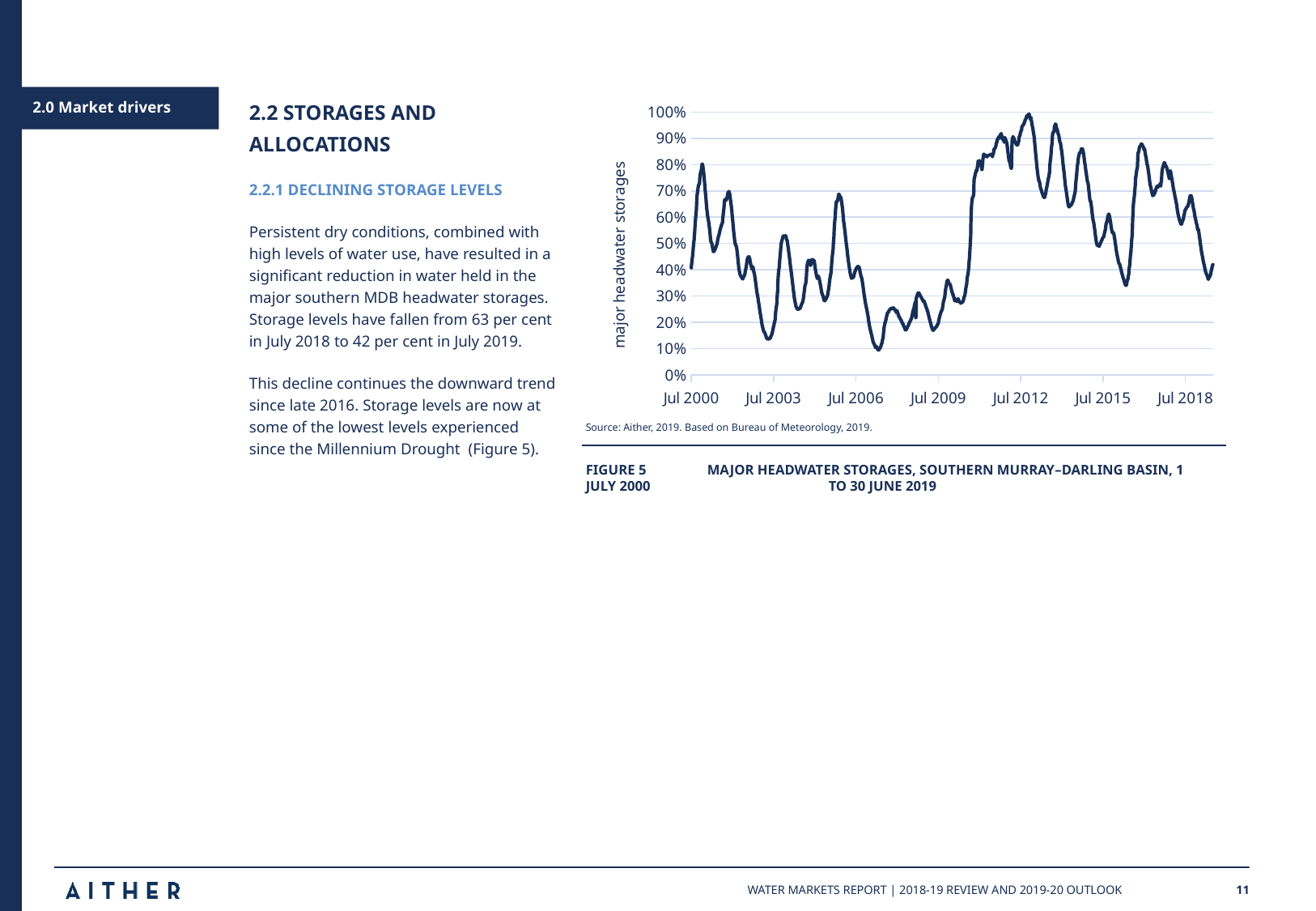
What kind of chart is shown on the slide? line chart Is the value of the line at Jul 2018 greater or less than 50%? greater Is the value of the line at Jul 2003 greater or less than 40%? less What is the title of the figure shown on the slide? Major headwater storages, Southern Murray–Darling Basin, 1 July 2000 to 30 June 2019 Is the peak value of the line around Jul 2012 greater or less than 90%? greater Between Jul 2009 and Jul 2012, does the line generally rise or fall? rise How many labelled tick marks are there on the horizontal axis of the chart? 7 Does the line reach its highest point closer to Jul 2012 or closer to Jul 2003? Jul 2012 What is the label on the vertical axis of the chart? major headwater storages From late 2016 to the end of the series in 2019, does the line generally rise or fall? fall